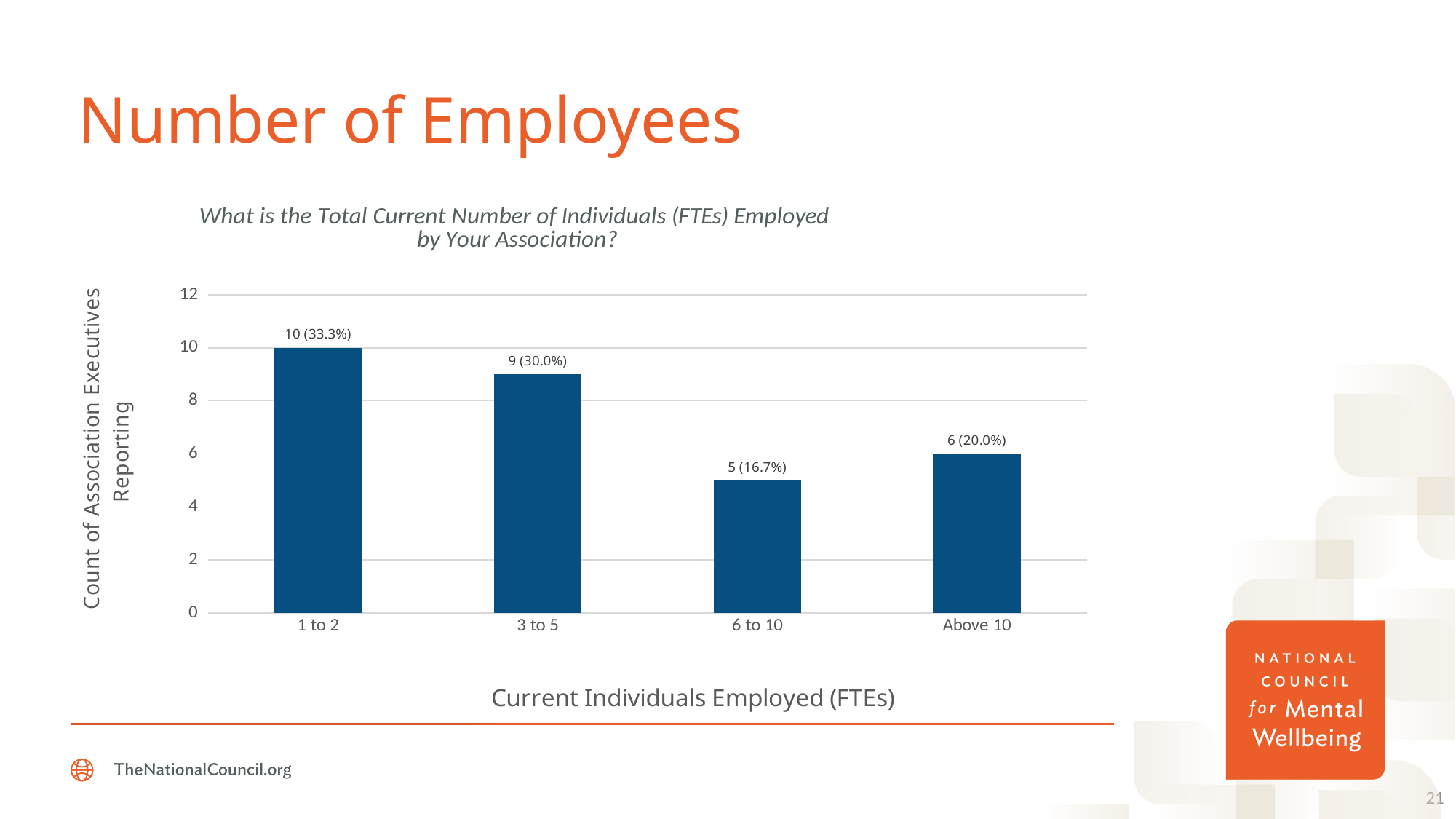
Which category has a larger count, 3 to 5 or Above 10? 3 to 5 What kind of chart is shown on the slide? Bar chart Which FTE category has the lowest count of association executives reporting? 6 to 10 What is the label of the x axis of the chart? Current Individuals Employed (FTEs) What is the difference in count between the 1 to 2 category and the 6 to 10 category? 5 Which FTE category has the highest count of association executives reporting? 1 to 2 What percentage of association executives reported Above 10 FTEs? 20.0% What is the count of association executives reporting 1 to 2 FTEs? 10 (33.3%) What is the count of association executives reporting 3 to 5 FTEs? 9 (30.0%) What is the count of association executives reporting 6 to 10 FTEs? 5 (16.7%) How many FTE categories are shown on the x axis? 4 Is the count for the Above 10 category greater or less than 8? less